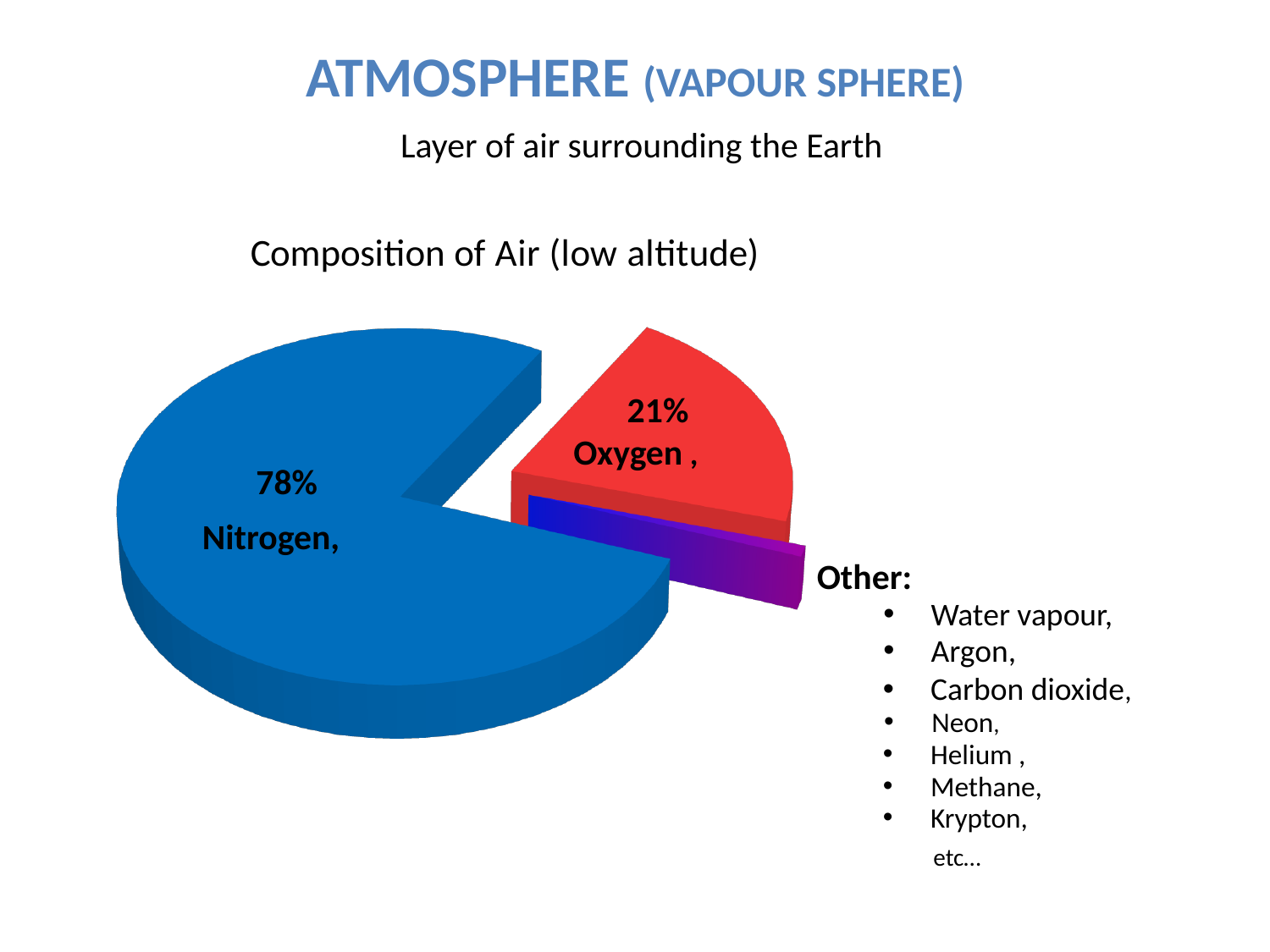
What share of the pie does the Oxygen slice represent? 21% What percentage of air does Nitrogen make up according to the pie chart? 78% What percentage of air does Oxygen make up according to the pie chart? 21% Which component has the largest slice in the pie chart? Nitrogen By how many percentage points does Nitrogen's share exceed Oxygen's share? 57 percentage points What colour is the Nitrogen slice in the pie chart? Blue Which component has the smallest slice in the pie chart? Other What type of chart is shown on the slide? Pie chart What is the title of the chart? Composition of Air (low altitude) How many slices does the pie chart have? 3 Which is larger in the pie chart, the Nitrogen slice or the Oxygen slice? Nitrogen